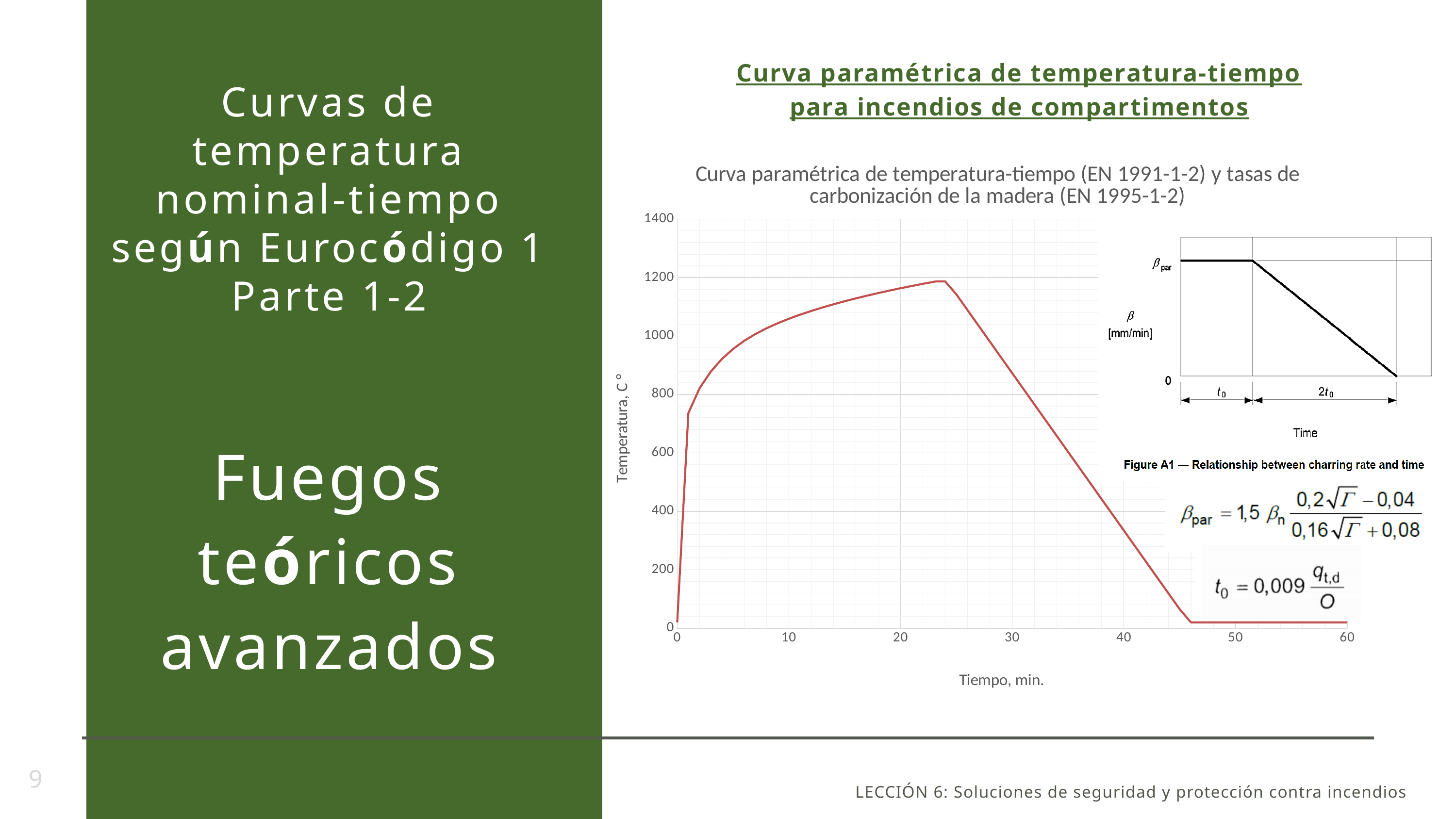
Is the temperature at 50 min greater or less than 200? less Does the temperature rise or fall between 30 and 40 min? fall Does the peak of the curve occur at a time greater or less than 30 min? less What kind of chart is used to show the parametric temperature-time curve? line chart What is the label of the x axis of the temperature-time chart? Tiempo, min. Is the maximum temperature reached by the curve greater or less than 1000? greater Does the temperature rise or fall between 0 and 20 min? rise What is the title of the chart on the right of the slide? Curva paramétrica de temperatura-tiempo (EN 1991-1-2) y tasas de carbonización de la madera (EN 1995-1-2) How many lines (series) are plotted in the temperature-time chart? 1